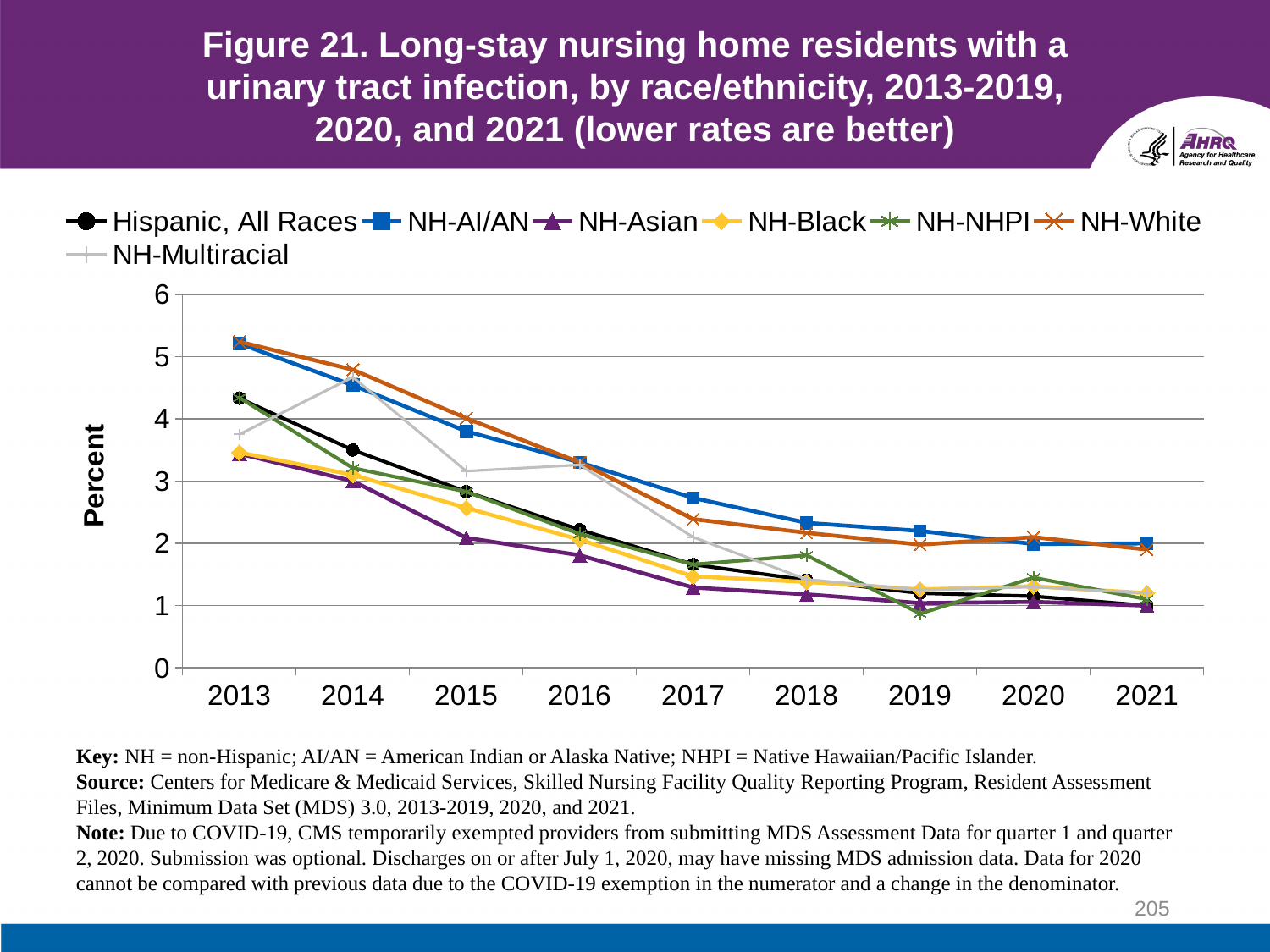
In 2014, which is larger: the value for NH-Multiracial or the value for Hispanic, All Races? NH-Multiracial Which race/ethnicity group has the lowest value in 2016? NH-Asian What is the label of the y axis? Percent Which series is plotted with a purple line and triangle markers? NH-Asian Is the value for NH-AI/AN in 2013 greater or less than 5? greater What kind of chart is shown on the slide? Line chart Is the value for NH-Asian in 2016 greater or less than 2? less How many series does the legend list? 7 How many years are plotted along the x axis? 9 Does the NH-AI/AN line rise or fall from 2013 to 2021? Fall Is the value for NH-Multiracial in 2014 greater or less than 4? greater Which race/ethnicity group has the highest value in 2017? NH-AI/AN